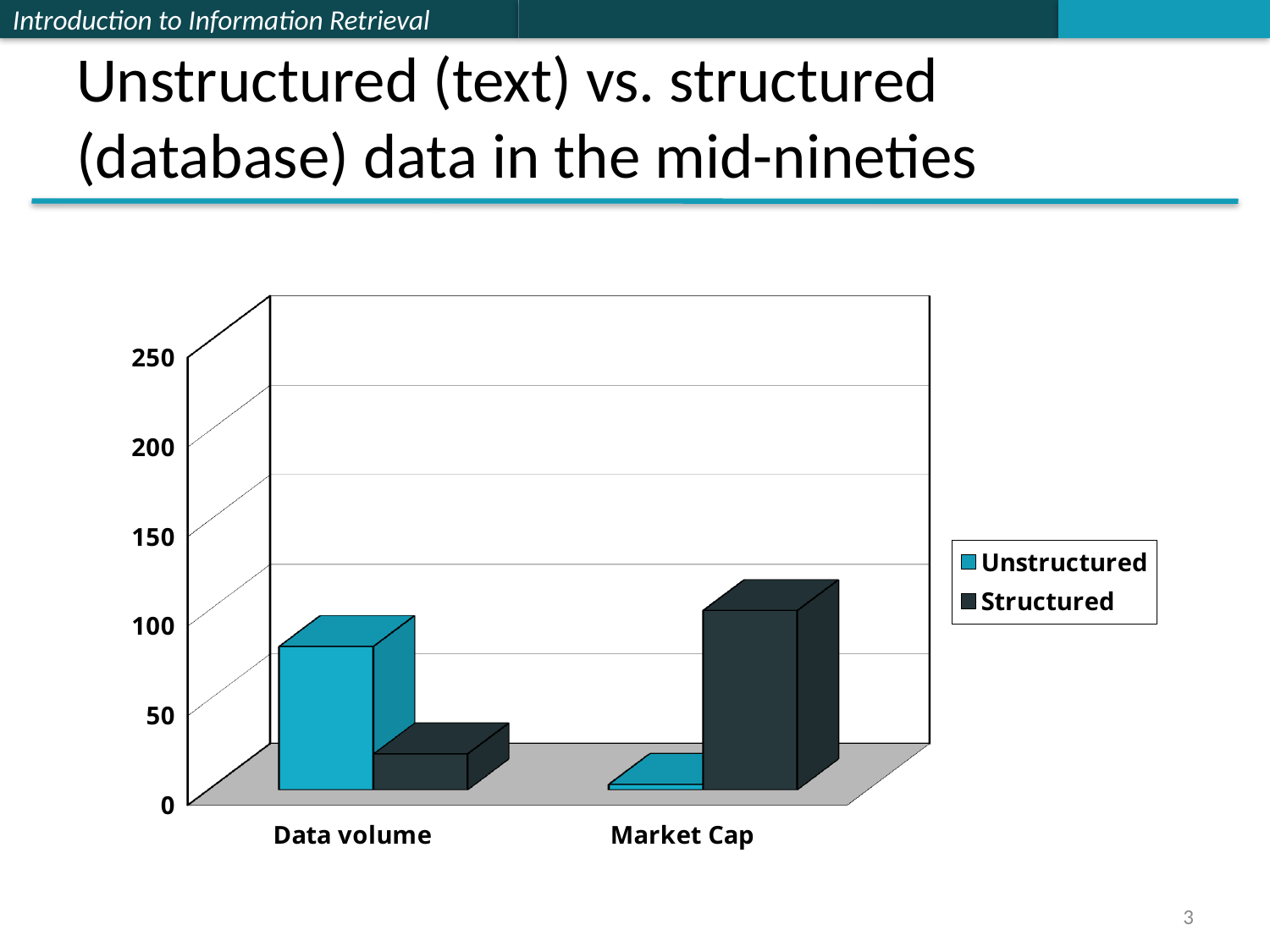
For Market Cap, which series has the larger value, Unstructured or Structured? Structured Is the Structured value for Market Cap greater or less than 200? less For Data volume, which series has the larger value, Unstructured or Structured? Unstructured What kind of chart is shown on the slide? bar chart Is the Unstructured value for Data volume greater or less than 50? greater Is the Unstructured value for Market Cap greater or less than 50? less Which series is drawn in the lighter blue colour in the chart? Unstructured What are the two series named in the legend? Unstructured and Structured How many categories are shown on the x axis of the chart? 2 Which category has the tallest bar in the chart? Market Cap How many series does the chart's legend list? 2